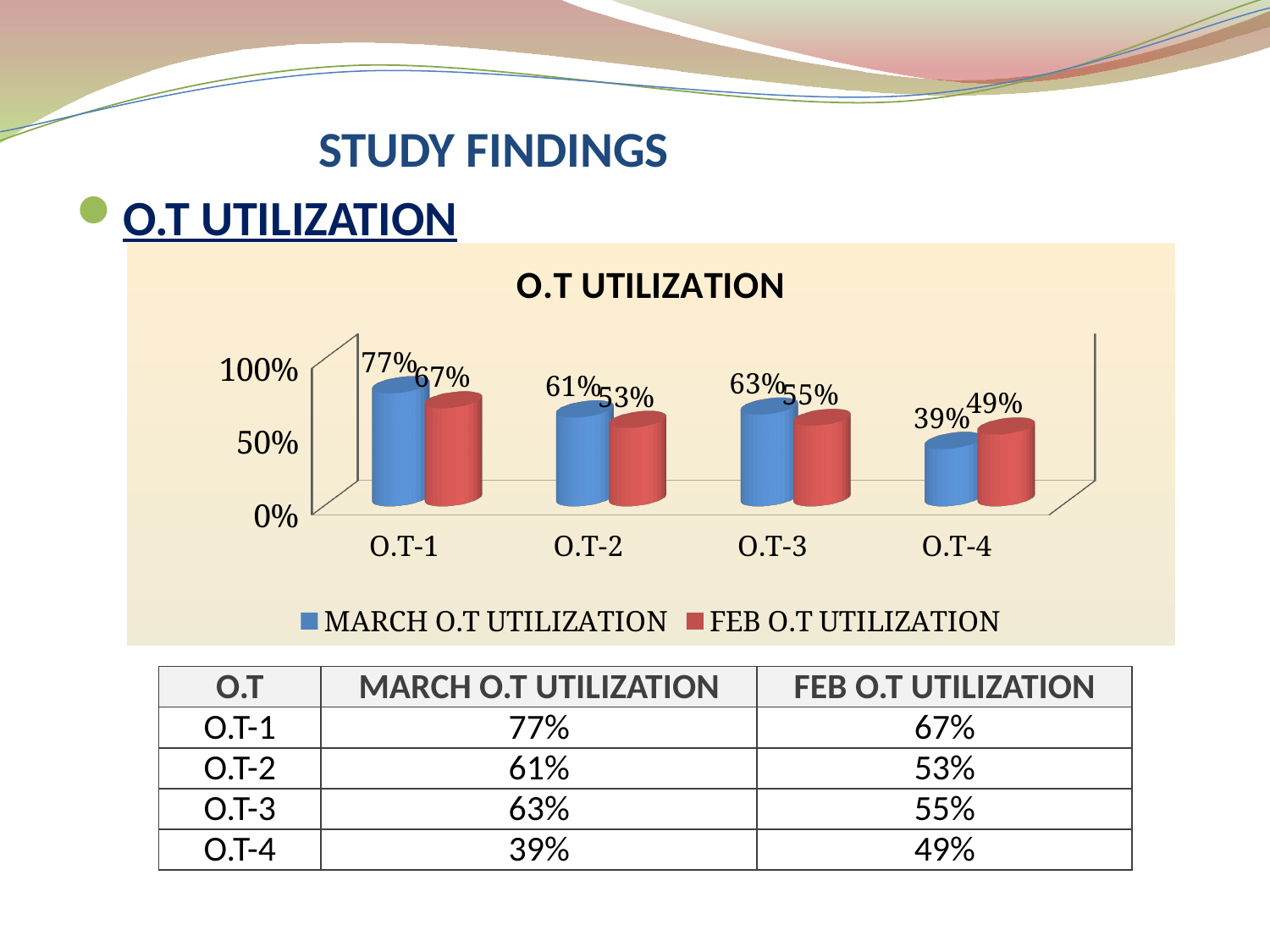
Is the March O.T utilization for O.T-3 greater or less than 50%? greater What is the Feb O.T utilization for O.T-4? 49% For O.T-4, which is larger: March O.T utilization or Feb O.T utilization? Feb O.T utilization What is the Feb O.T utilization for O.T-2? 53% What is the difference between the March and Feb O.T utilization for O.T-1? 10% How many series does the legend list? 2 What kind of chart is shown? bar chart What is the March O.T utilization for O.T-1? 77% Which O.T has the highest March O.T utilization? O.T-1 What is the title of the chart? O.T UTILIZATION Which O.T has the lowest Feb O.T utilization? O.T-4 How many O.T categories are shown on the x axis? 4